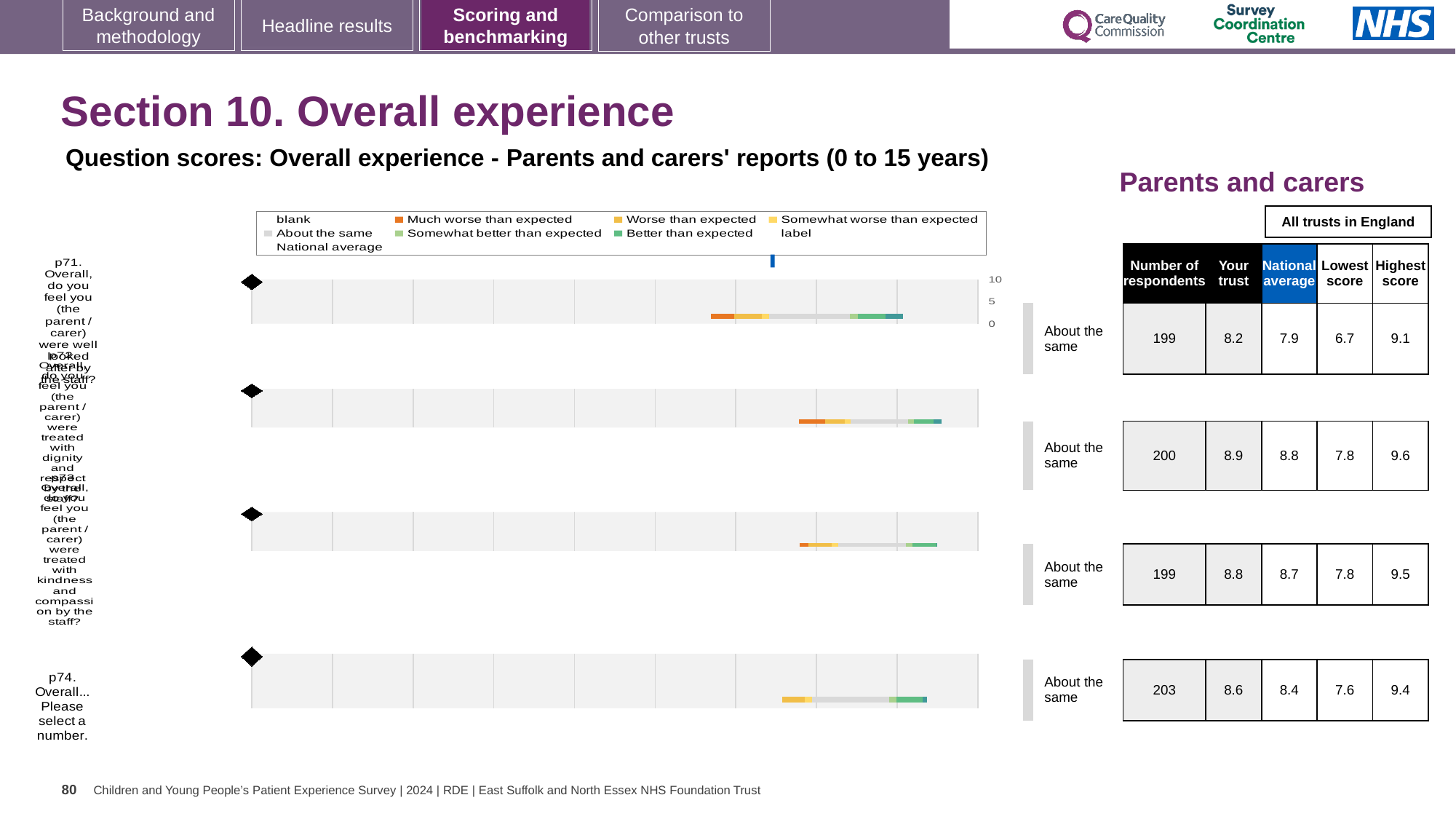
What benchmark category is shown next to each of the four question rows? About the same What kind of chart is used to show the question scores on this slide? bar chart Which row has the lowest 'Your trust' score? the first row, p71 (8.2) For the last row (p74), which is larger: the 'Your trust' score or the national average? Your trust (8.6) For the first row (p71), what is the difference between the 'Your trust' score and the national average? 0.3 How many question rows are plotted in the chart? 4 What is the national average score for the last row (p74, Overall... Please select a number)? 8.4 What is the title of the chart? Question scores: Overall experience - Parents and carers' reports (0 to 15 years) What is the highest score across all trusts in England for the last row (p74)? 9.4 How many respondents are listed for the last row (p74)? 203 What is the 'Your trust' score for the first row (p71, overall well looked after by the staff)? 8.2 Which row has the highest 'Your trust' score? the second row (8.9)